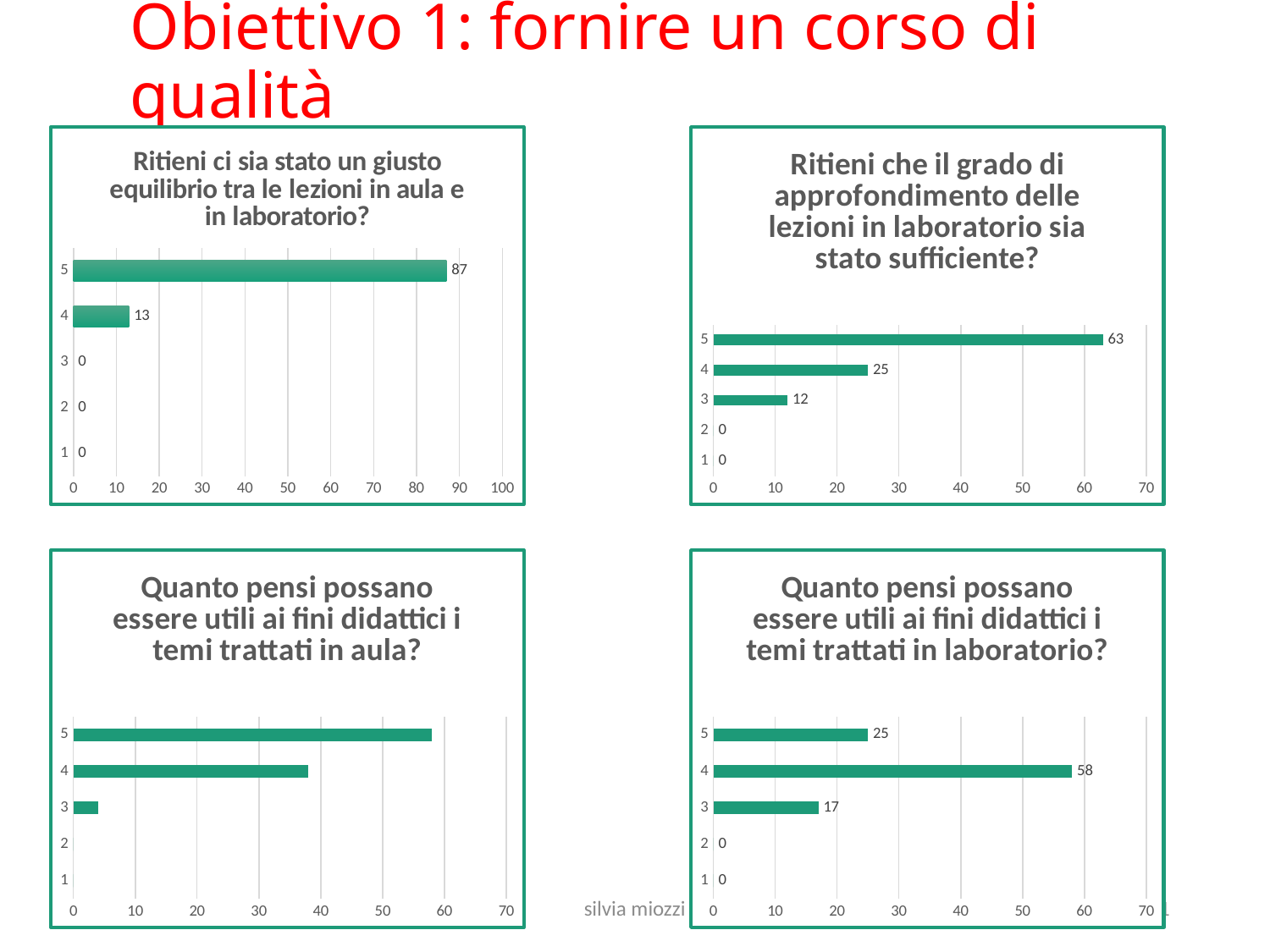
How many categories are shown in the chart titled "Quanto pensi possano essere utili ai fini didattici i temi trattati in laboratorio?"? 5 In the chart titled "Quanto pensi possano essere utili ai fini didattici i temi trattati in laboratorio?", what is the value for category 4? 58 In the chart titled "Quanto pensi possano essere utili ai fini didattici i temi trattati in aula?", is the value for category 3 greater or less than 10? less In the chart titled "Quanto pensi possano essere utili ai fini didattici i temi trattati in aula?", which is larger, the value for category 5 or category 4? 5 In the chart titled "Ritieni ci sia stato un giusto equilibrio tra le lezioni in aula e in laboratorio?", what is the value for category 5? 87 In the chart titled "Ritieni che il grado di approfondimento delle lezioni in laboratorio sia stato sufficiente?", what is the difference between the values for categories 4 and 3? 13 In the chart titled "Quanto pensi possano essere utili ai fini didattici i temi trattati in aula?", is the value for category 5 greater or less than 50? greater In the chart titled "Ritieni che il grado di approfondimento delle lezioni in laboratorio sia stato sufficiente?", which category has the highest value? 5 In the chart titled "Quanto pensi possano essere utili ai fini didattici i temi trattati in laboratorio?", which category has the highest value? 4 What type of chart is the chart titled "Ritieni ci sia stato un giusto equilibrio tra le lezioni in aula e in laboratorio?"? Bar chart In the chart titled "Ritieni che il grado di approfondimento delle lezioni in laboratorio sia stato sufficiente?", what is the value for category 3? 12 In the chart titled "Ritieni ci sia stato un giusto equilibrio tra le lezioni in aula e in laboratorio?", what is the difference between the values for categories 5 and 4? 74